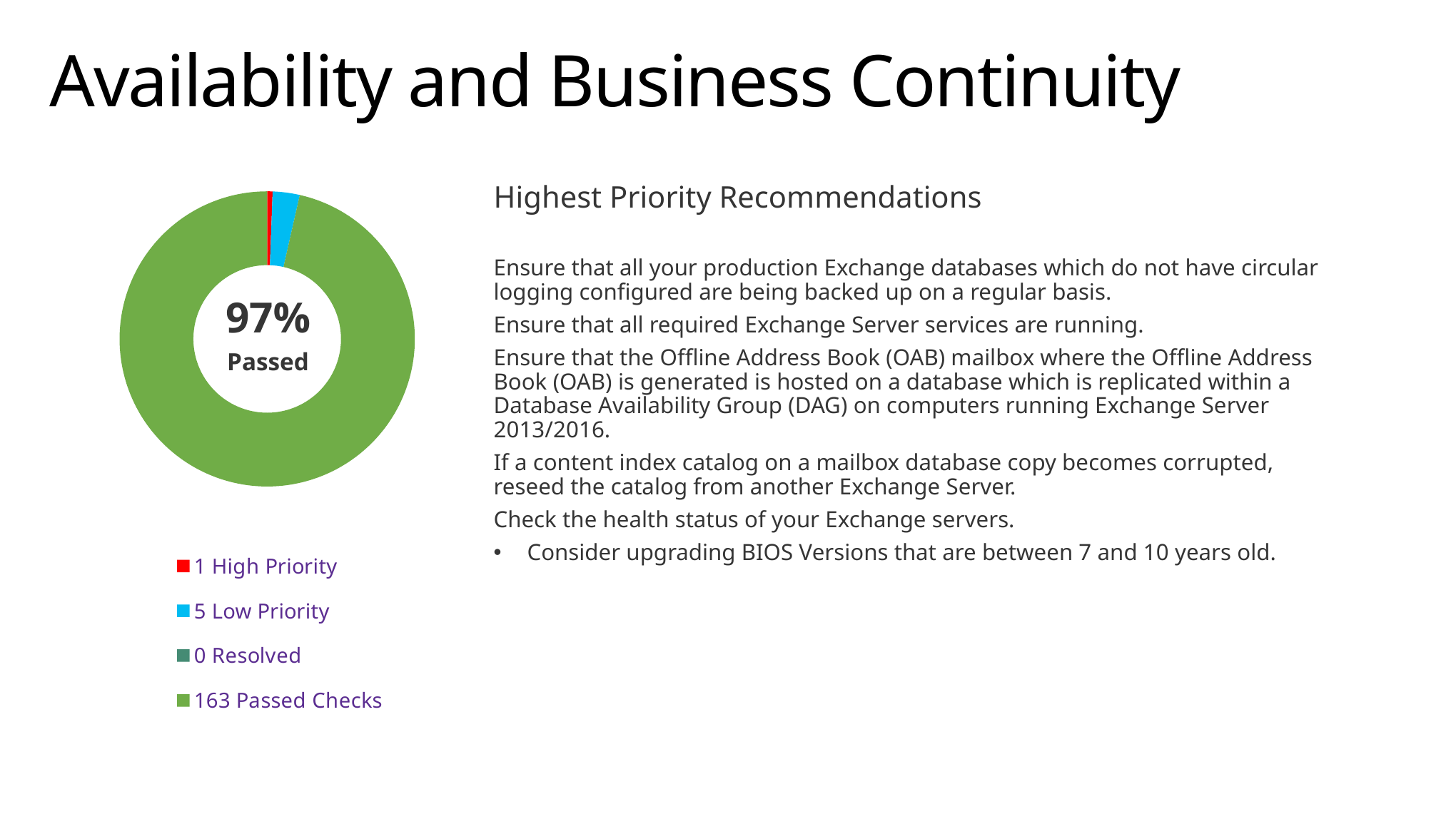
What kind of chart is shown on the slide? Donut chart How many High Priority items does the chart legend show? 1 Which is larger, the number of Low Priority items or the number of High Priority items? Low Priority How many checks are shown as Passed Checks in the chart legend? 163 What percentage is shown in the centre of the donut chart? 97% How many Low Priority items does the chart legend show? 5 How many categories does the chart legend list? 4 What is the difference between the number of Low Priority items and High Priority items? 4 How many Resolved items does the chart legend show? 0 Which category has the largest value in the chart? Passed Checks Which category has the smallest value in the chart? Resolved What colour represents Passed Checks in the chart? Green